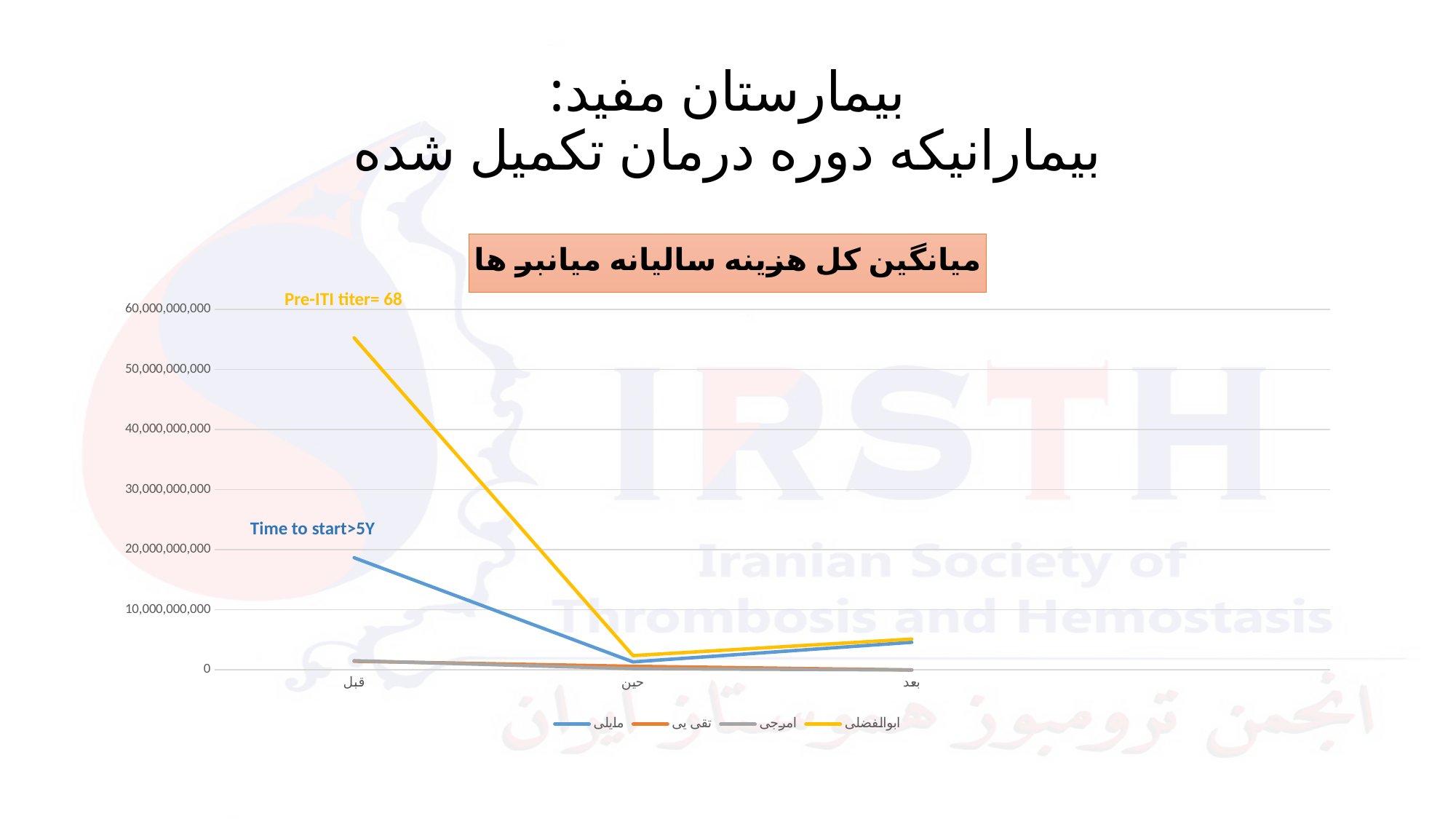
Does the ابوالفضلی line rise or fall from قبل to حین? fall Which series has the highest value at قبل? ابوالفضلی What kind of chart is shown on the slide? line chart How many series does the chart legend list? 4 At بعد, which is larger: the value for ابوالفضلی or the value for امرجی? ابوالفضلی How many categories are shown on the x axis of the chart? 3 Is the value for ابوالفضلی at حین greater or less than 10,000,000,000? less What colour is the line for ابوالفضلی in the chart? yellow Is the value for ابوالفضلی at قبل greater or less than 50,000,000,000? greater